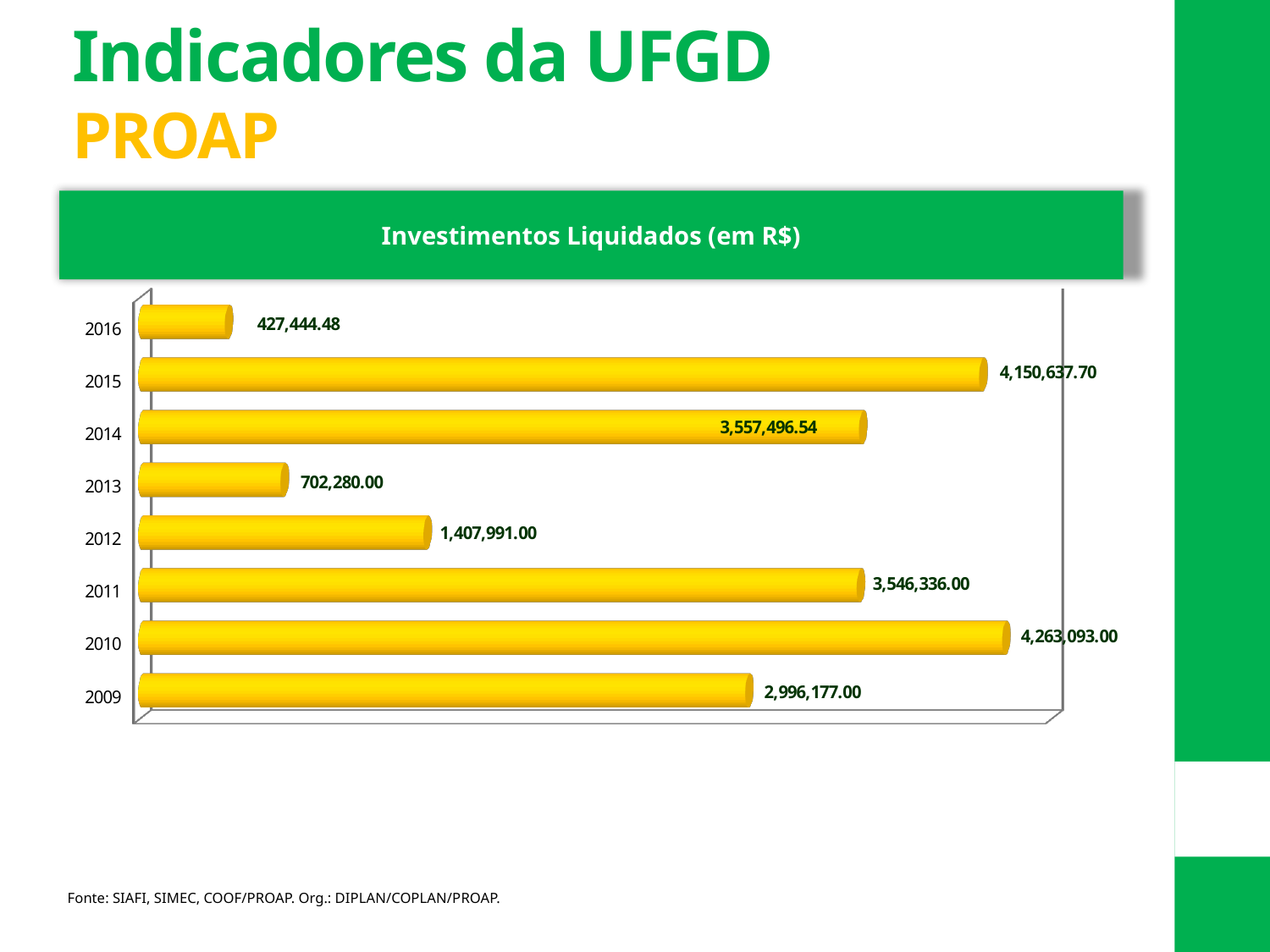
How many years are shown in the Investimentos Liquidados (em R$) chart? 8 What is the value for 2013 in the Investimentos Liquidados (em R$) chart? 702,280.00 What is the difference between the values for 2013 and 2016 in the Investimentos Liquidados (em R$) chart? 274,835.52 What kind of chart is the Investimentos Liquidados (em R$) chart? Bar chart What is the value for 2009 in the Investimentos Liquidados (em R$) chart? 2,996,177.00 Which year has the larger value in the Investimentos Liquidados (em R$) chart, 2009 or 2012? 2009 What is the title of the chart on the slide? Investimentos Liquidados (em R$) Which year has the highest value in the Investimentos Liquidados (em R$) chart? 2010 What is the difference between the values for 2010 and 2015 in the Investimentos Liquidados (em R$) chart? 112,455.30 What is the value for 2012 in the Investimentos Liquidados (em R$) chart? 1,407,991.00 What is the value for 2015 in the Investimentos Liquidados (em R$) chart? 4,150,637.70 Which year has the lowest value in the Investimentos Liquidados (em R$) chart? 2016